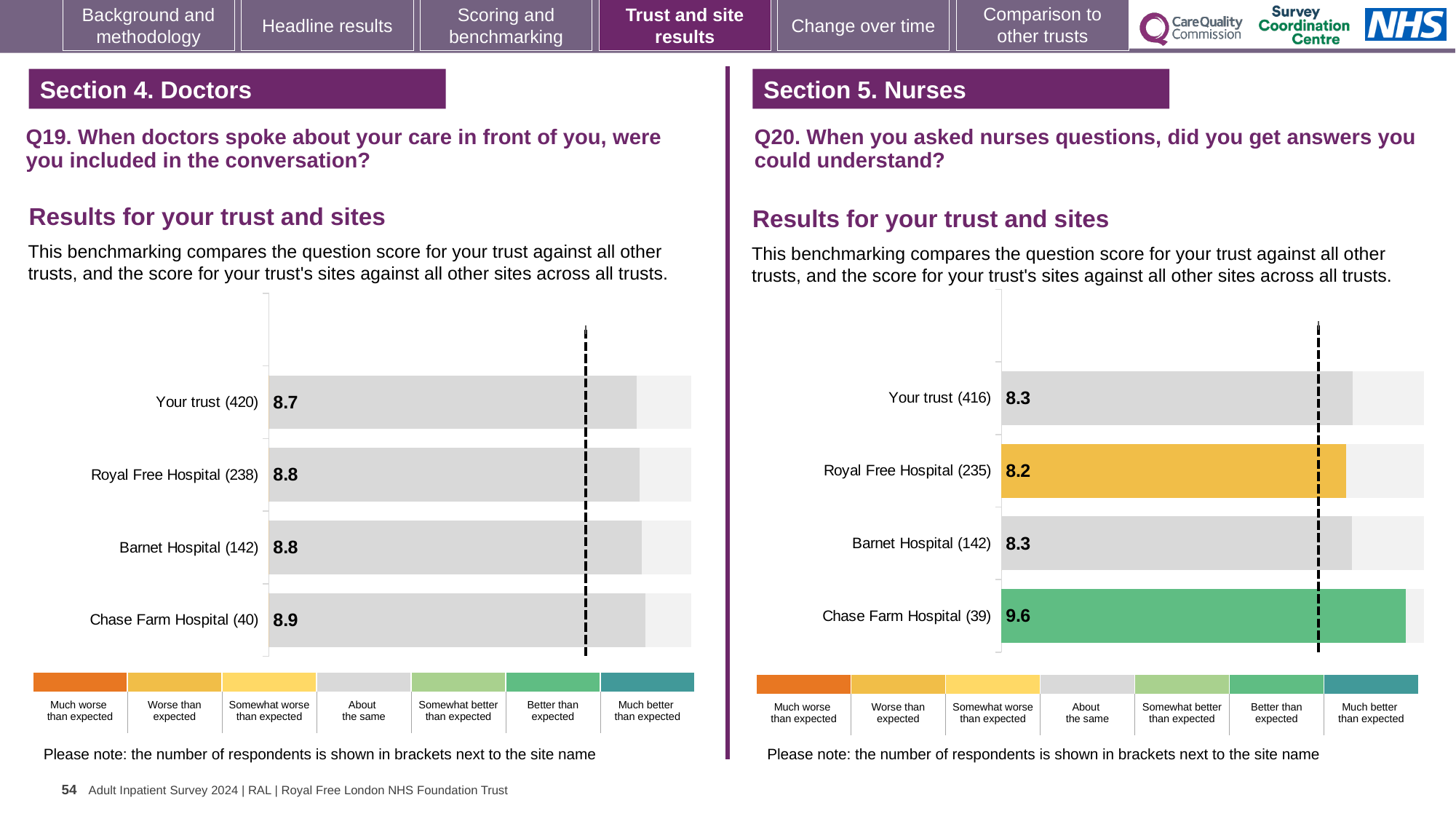
On the Q20 chart (right), which site or trust has the lowest score? Royal Free Hospital On the Q20 chart (right), what is the score for Royal Free Hospital? 8.2 On the Q20 chart (right), what is the score for Chase Farm Hospital? 9.6 On the Q19 chart (left), how many bars are plotted? 4 On the Q19 chart (left), what is the score for Your trust? 8.7 On the Q20 chart (right), which is larger: the score for Chase Farm Hospital or the score for Barnet Hospital? Chase Farm Hospital On the Q19 chart (left), which site or trust has the highest score? Chase Farm Hospital What kind of chart is used on the Q20 chart (right)? Bar chart On the Q20 chart (right), what is the difference between the scores for Chase Farm Hospital and Your trust? 1.3 On the Q20 chart (right), how many respondents are shown in brackets for Chase Farm Hospital? 39 On the Q19 chart (left), what is the score for Chase Farm Hospital? 8.9 On the Q19 chart (left), what is the difference between the scores for Chase Farm Hospital and Your trust? 0.2